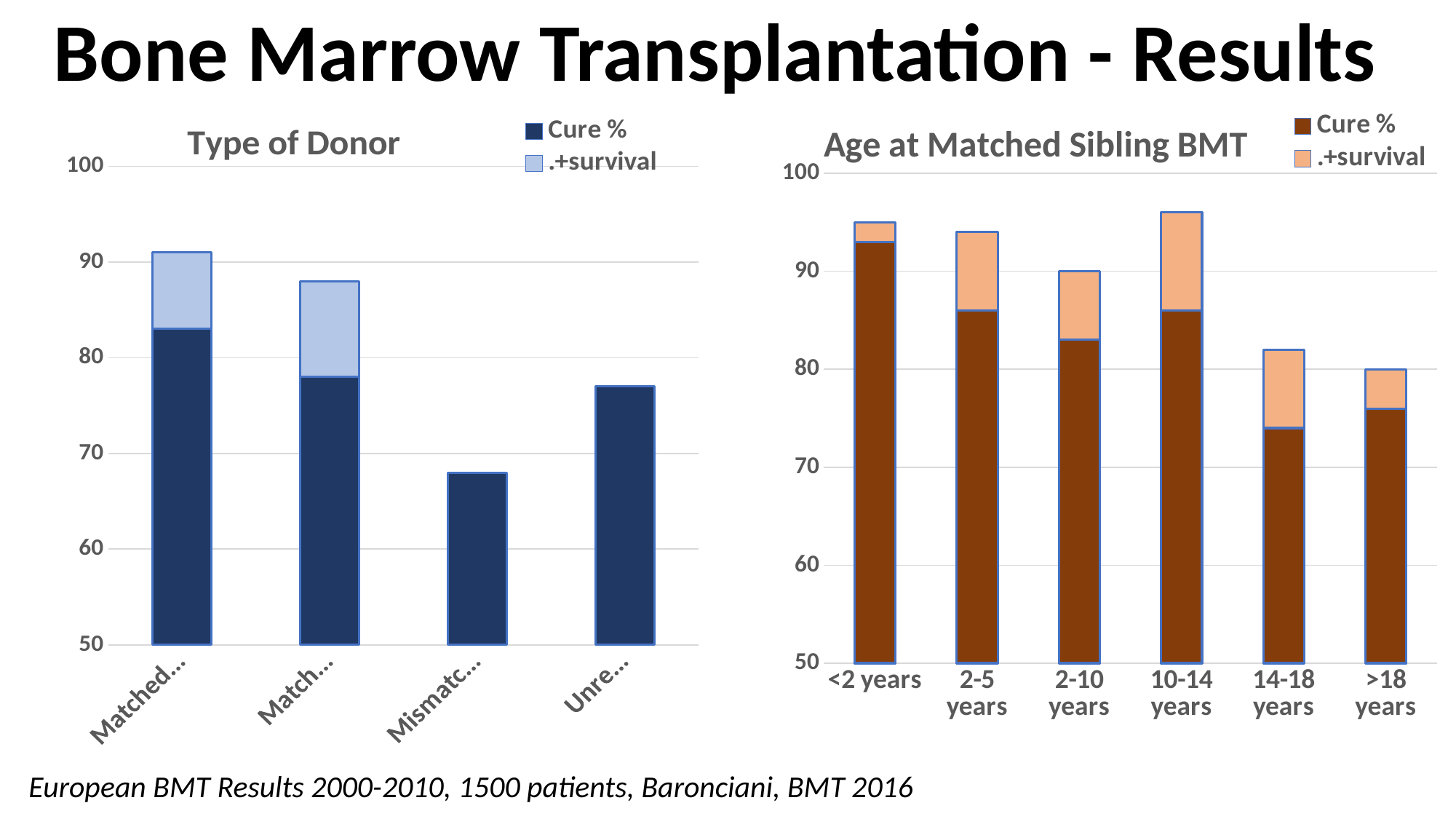
How many series does the legend of the 'Age at Matched Sibling BMT' chart list? 2 What are the two legend entries of the 'Type of Donor' chart? Cure % and .+survival In the 'Age at Matched Sibling BMT' chart, which age group has the highest Cure %? <2 years In the 'Age at Matched Sibling BMT' chart, which has the larger Cure %: '2-5 years' or '14-18 years'? 2-5 years In the 'Age at Matched Sibling BMT' chart, does the Cure % rise or fall from '10-14 years' to '14-18 years'? fall In the 'Age at Matched Sibling BMT' chart, is the Cure % for '14-18 years' greater or less than 80? less In the 'Type of Donor' chart, is the value of the third bar from the left greater or less than 70? less How many age groups are shown on the x axis of the 'Age at Matched Sibling BMT' chart? 6 How many bars are plotted in the 'Type of Donor' chart? 4 In the 'Age at Matched Sibling BMT' chart, is the Cure % for '<2 years' greater or less than 90? greater What is the title of the left-hand chart on the slide? Type of Donor What kind of chart is the 'Age at Matched Sibling BMT' chart? Stacked bar chart